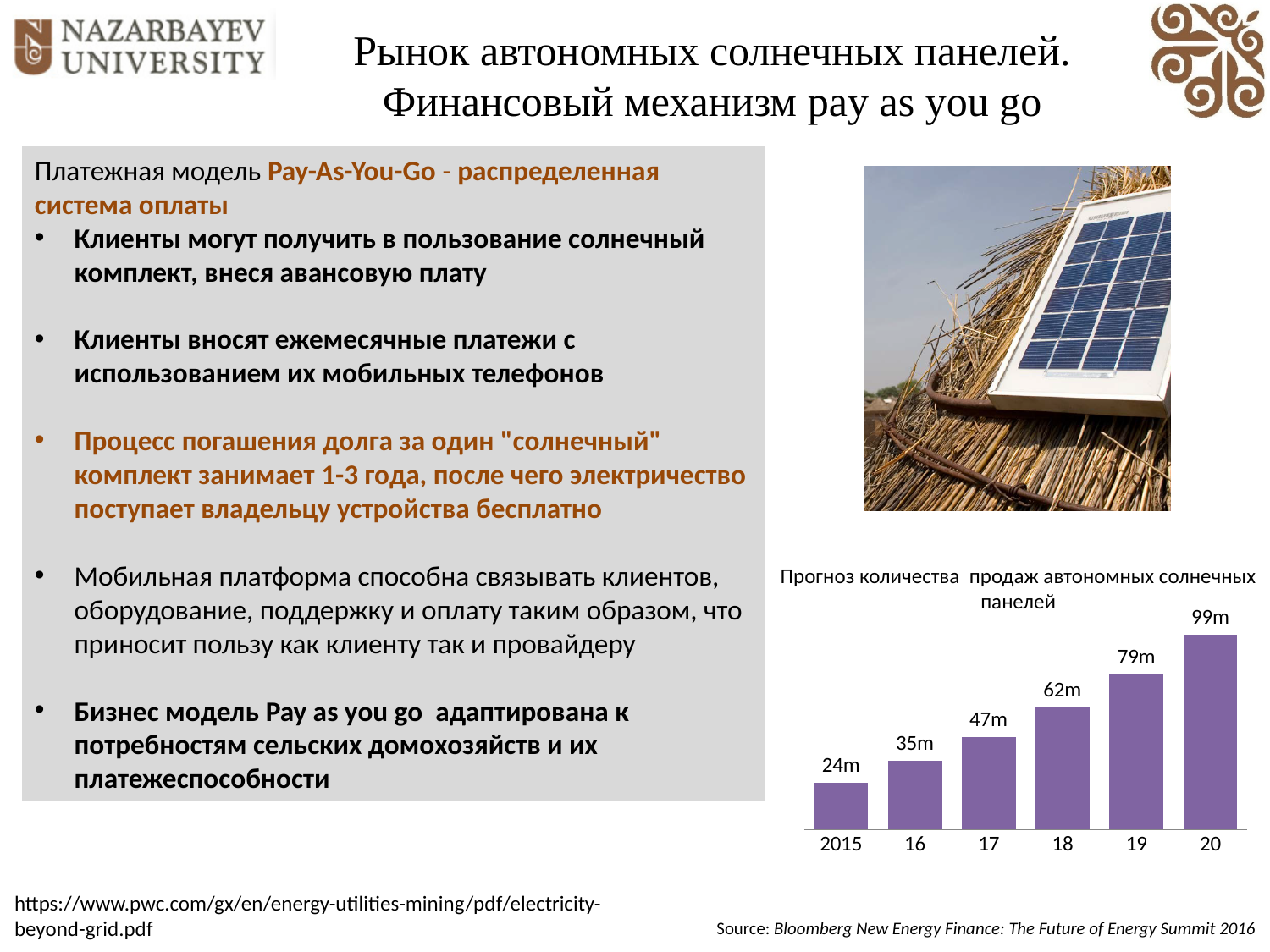
Which year has the highest forecast value in the chart? 20 How many bars are plotted in the chart? 6 What value is shown for 18 in the chart? 62m What value is shown for 20 in the chart? 99m What colour are the bars in the chart? purple What is the title of the chart on the slide? Прогноз количества продаж автономных солнечных панелей What is the forecast value for 2015 in the chart 'Прогноз количества продаж автономных солнечных панелей'? 24m What type of chart is shown on the slide? bar chart Which is larger in the chart, the value for 16 or the value for 18? 18 What is the difference between the values for 19 and 17 in the chart? 32m Which year has the lowest forecast value in the chart? 2015 Do the values in the chart rise or fall from 2015 to 20? rise